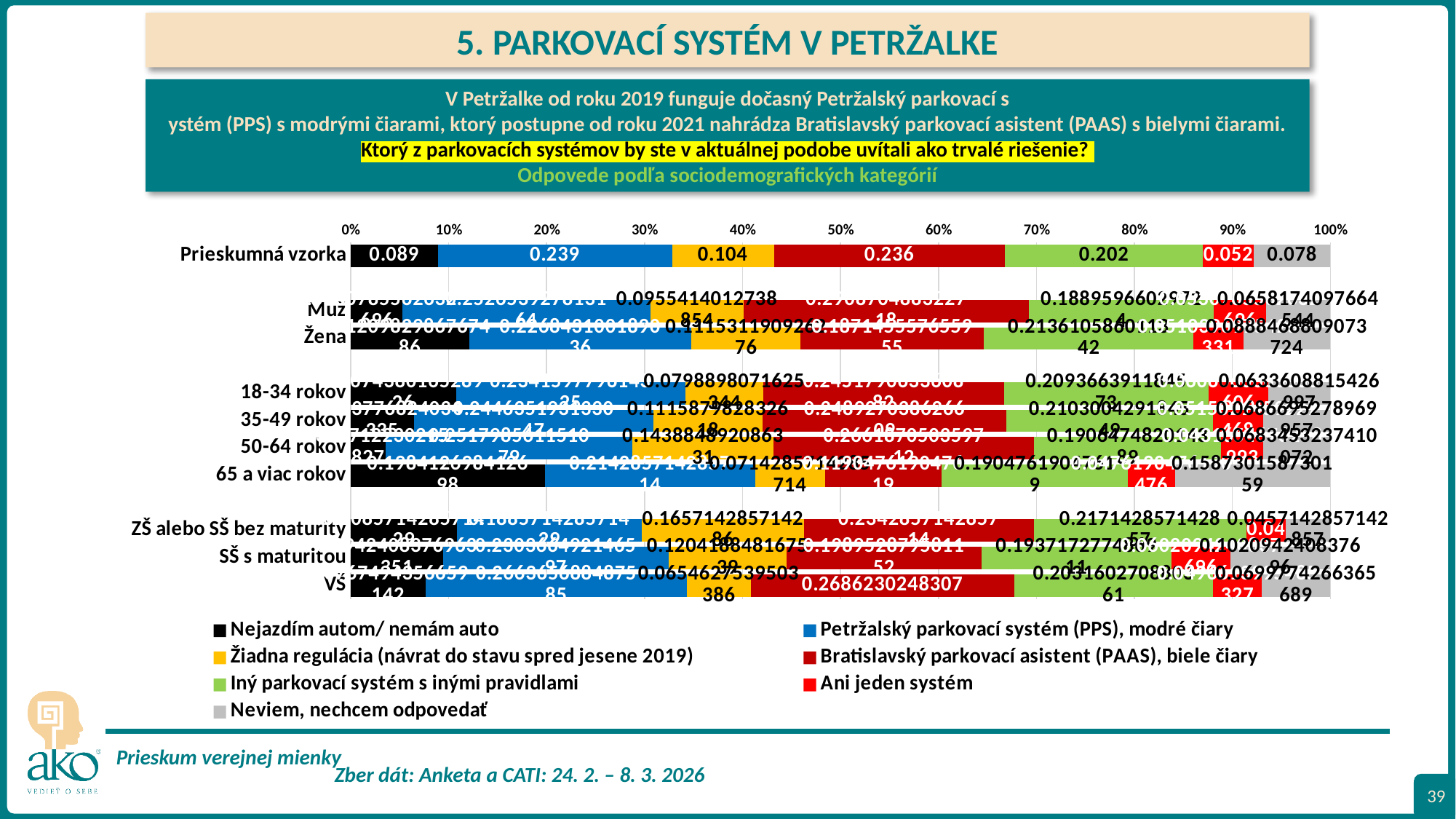
In the Prieskumná vzorka bar, what is the value for 'Ani jeden systém'? 0.052 In the Prieskumná vzorka bar, what is the value for 'Petržalský parkovací systém (PPS), modré čiary'? 0.239 In the Prieskumná vzorka bar, what is the value for 'Žiadna regulácia (návrat do stavu spred jesene 2019)'? 0.104 In the Prieskumná vzorka bar, what is the value for 'Iný parkovací systém s inými pravidlami'? 0.202 How many series does the legend list? 7 In the Prieskumná vzorka bar, what is the value for 'Nejazdím autom/ nemám auto'? 0.089 In the Prieskumná vzorka bar, what is the difference between the value for 'Iný parkovací systém s inými pravidlami' and the value for 'Neviem, nechcem odpovedať'? 0.124 In the Prieskumná vzorka bar, what is the value for 'Neviem, nechcem odpovedať'? 0.078 In the Prieskumná vzorka bar, which series has the smallest value? Ani jeden systém In the Prieskumná vzorka bar, what is the value for 'Bratislavský parkovací asistent (PAAS), biele čiary'? 0.236 In the Prieskumná vzorka bar, which is larger: the value for 'Nejazdím autom/ nemám auto' or the value for 'Neviem, nechcem odpovedať'? Nejazdím autom/ nemám auto What kind of chart is shown on the slide? Stacked bar chart